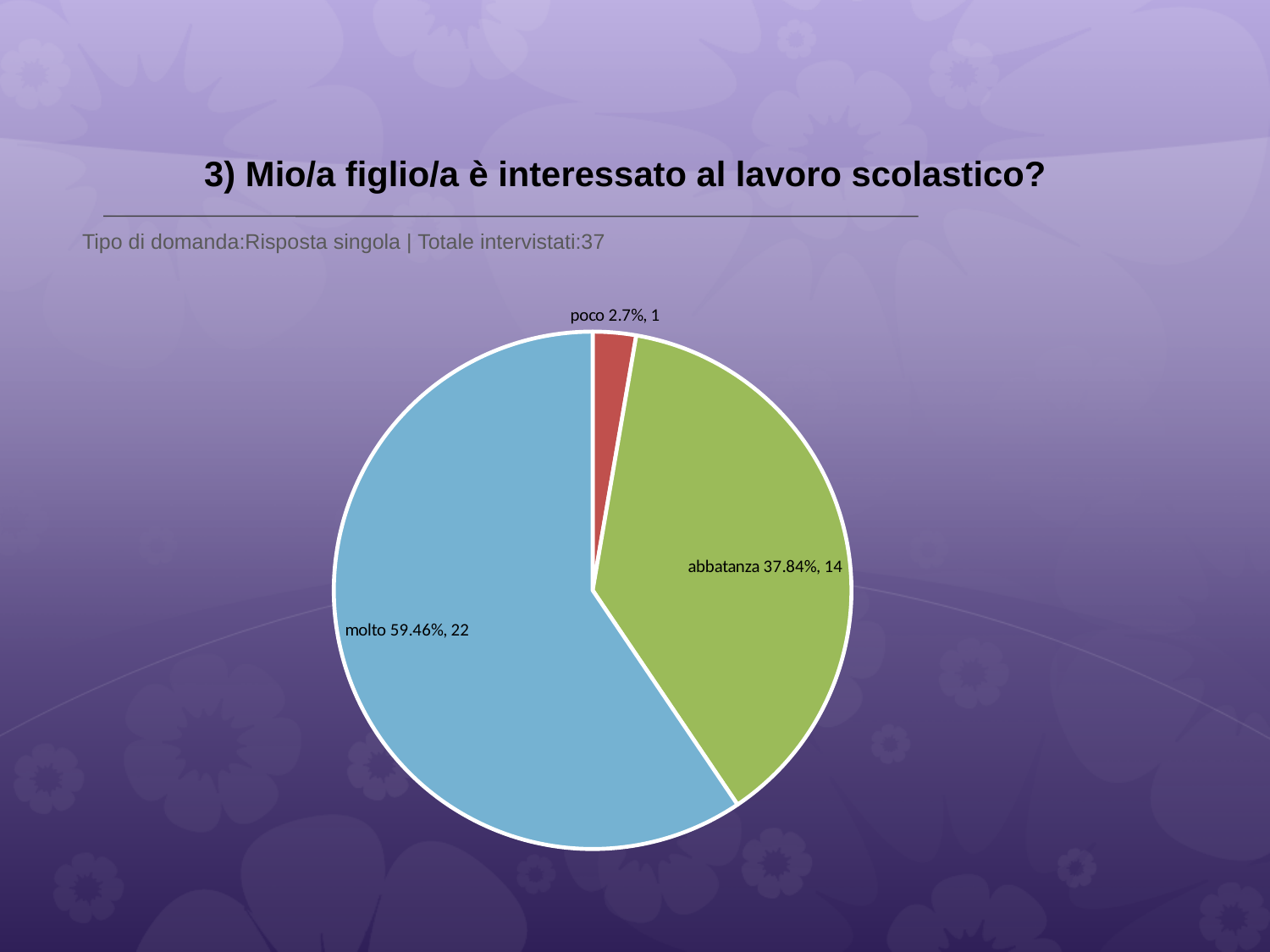
Which category has the smallest slice? poco What kind of chart is shown on the slide? pie chart Which slice is larger, "abbatanza" or "poco"? abbatanza Which category has the largest slice? molto How many respondents answered "molto"? 22 What percentage share does the "abbatanza" slice have? 37.84% How many respondents answered "poco"? 1 What is the difference in respondent count between "molto" and "abbatanza"? 8 What percentage share does the "poco" slice have? 2.7% How many respondents answered "abbatanza"? 14 What percentage share does the "molto" slice have? 59.46% How many slices does the pie chart have? 3